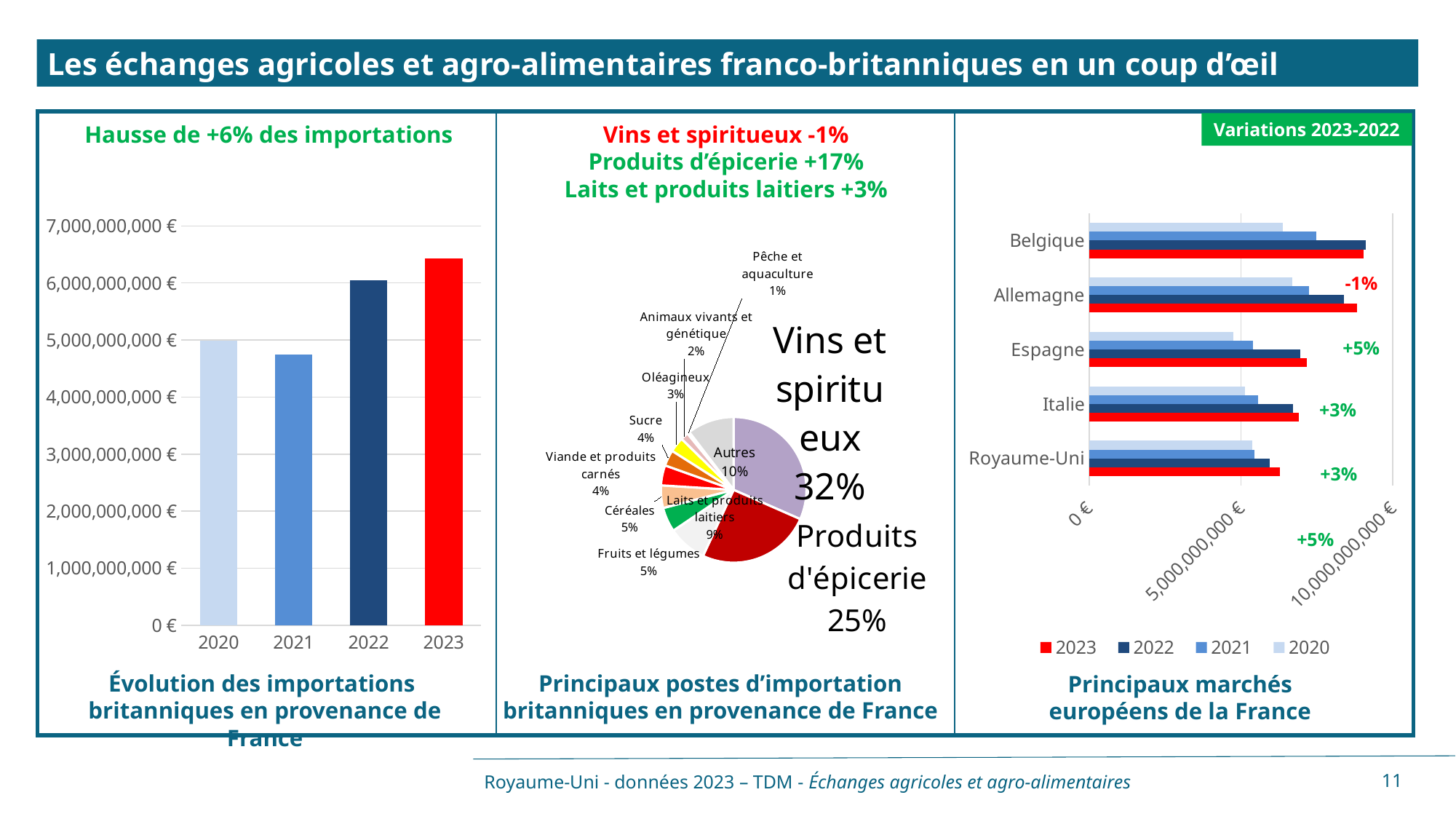
In the left chart 'Évolution des importations britanniques en provenance de France', how many years are plotted? 4 In the middle pie chart 'Principaux postes d'importation britanniques en provenance de France', what share does 'Vins et spiritueux' have? 32% In the right chart 'Principaux marchés européens de la France', how many series does the legend list? 4 In the middle pie chart 'Principaux postes d'importation britanniques en provenance de France', which slice is the smallest? Pêche et aquaculture In the middle pie chart 'Principaux postes d'importation britanniques en provenance de France', how many percentage points larger is 'Vins et spiritueux' than 'Produits d'épicerie'? 7 In the middle pie chart 'Principaux postes d'importation britanniques en provenance de France', what share does 'Laits et produits laitiers' have? 9% In the left chart 'Évolution des importations britanniques en provenance de France', which year has the lowest value? 2021 In the left chart 'Évolution des importations britanniques en provenance de France', which year has the highest value? 2023 What kind of chart is the left chart, 'Évolution des importations britanniques en provenance de France'? bar chart In the right chart 'Principaux marchés européens de la France', which country has the highest 2023 value? Belgique In the left chart 'Évolution des importations britanniques en provenance de France', is the value for 2021 greater or less than 5,000,000,000 €? less In the left chart 'Évolution des importations britanniques en provenance de France', is the value for 2023 greater or less than 6,000,000,000 €? greater